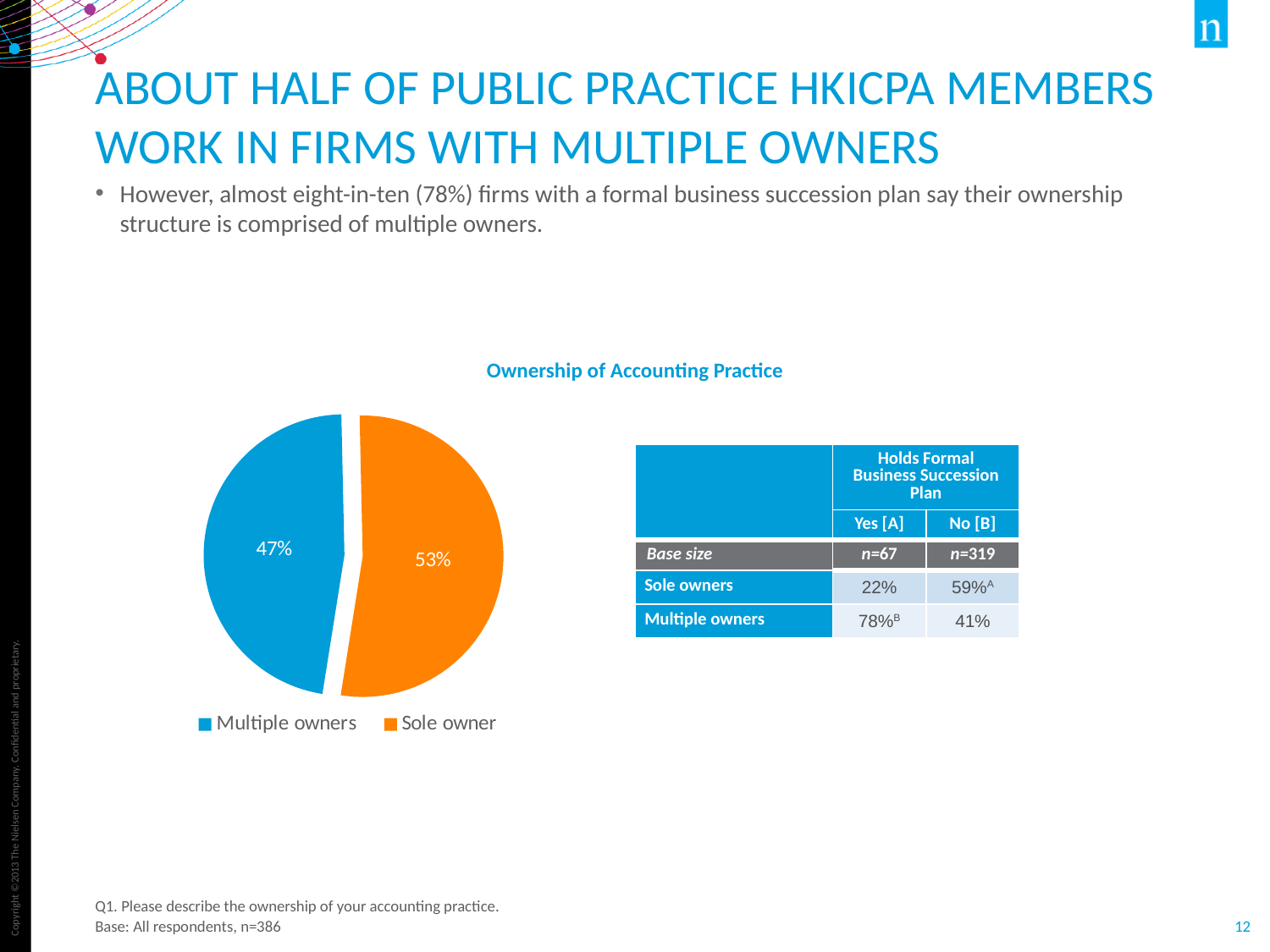
What colour is the Multiple owners slice? blue What is the title of the chart? Ownership of Accounting Practice What kind of chart is shown on the slide? pie chart Which slice of the pie is the smallest? Multiple owners Which is larger, the Sole owner slice or the Multiple owners slice? Sole owner What share of the pie is labelled Sole owner? 53% Which slice of the pie is the largest? Sole owner What is the value shown for the Sole owner slice? 53% What share of the pie is labelled Multiple owners? 47% What is the difference in percentage points between the Sole owner slice and the Multiple owners slice? 6 How many entries does the chart legend list? 2 How many slices does the pie chart have? 2